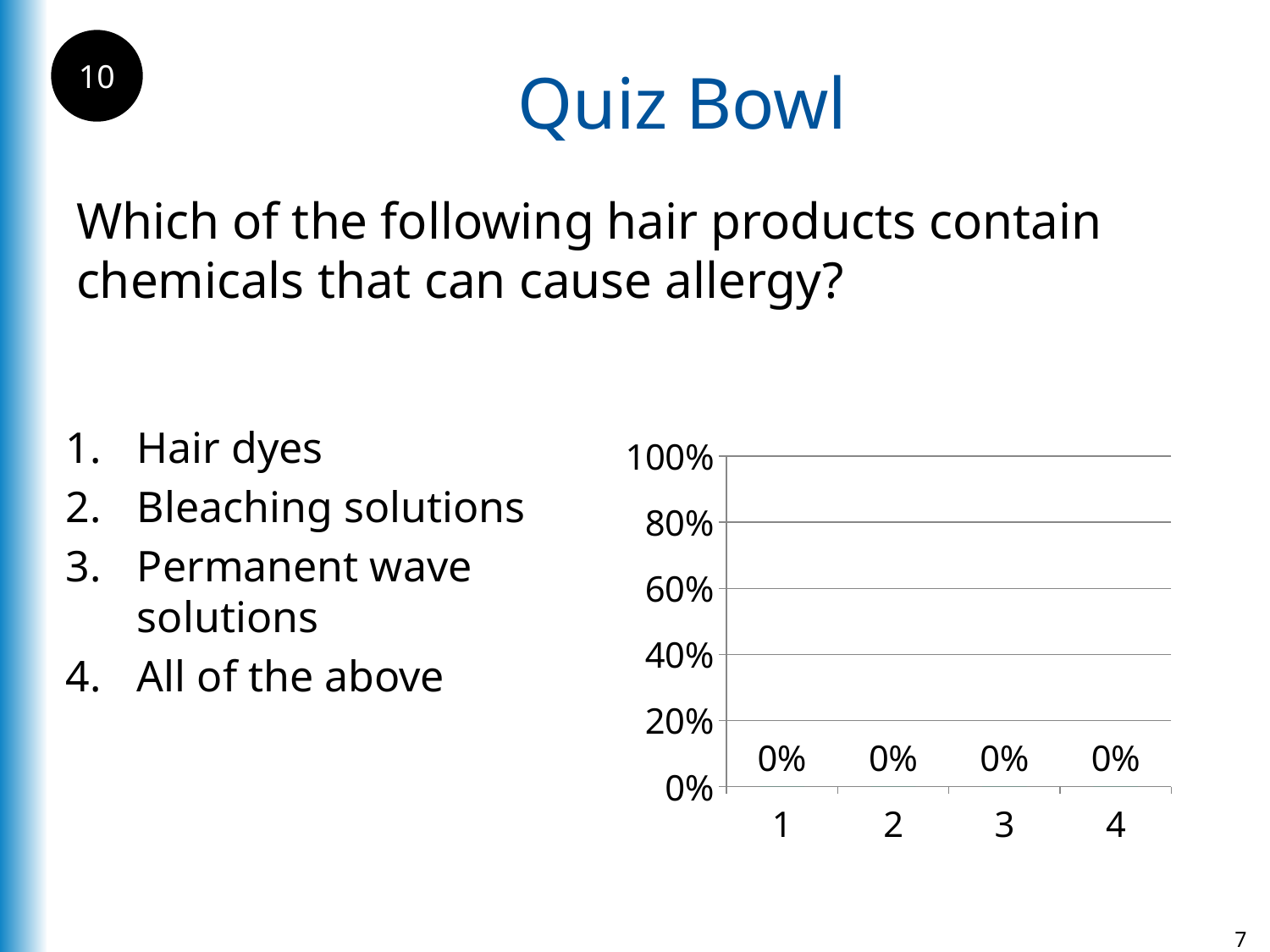
What kind of chart is shown on the slide? bar chart Is the value for category 2 greater or less than 20%? less What is the difference between the values for category 1 and category 4? 0% What is the value shown for category 3 in the chart? 0% What is the interval between the tick marks on the y axis of the chart? 20% How many categories are shown on the x axis of the chart? 4 What is the highest value shown on the y axis of the chart? 100% Do the values rise, fall, or stay the same from category 1 to category 4? stay the same What is the value shown for category 1 in the chart? 0% What is the value shown for category 2 in the chart? 0% What is the value shown for category 4 in the chart? 0%